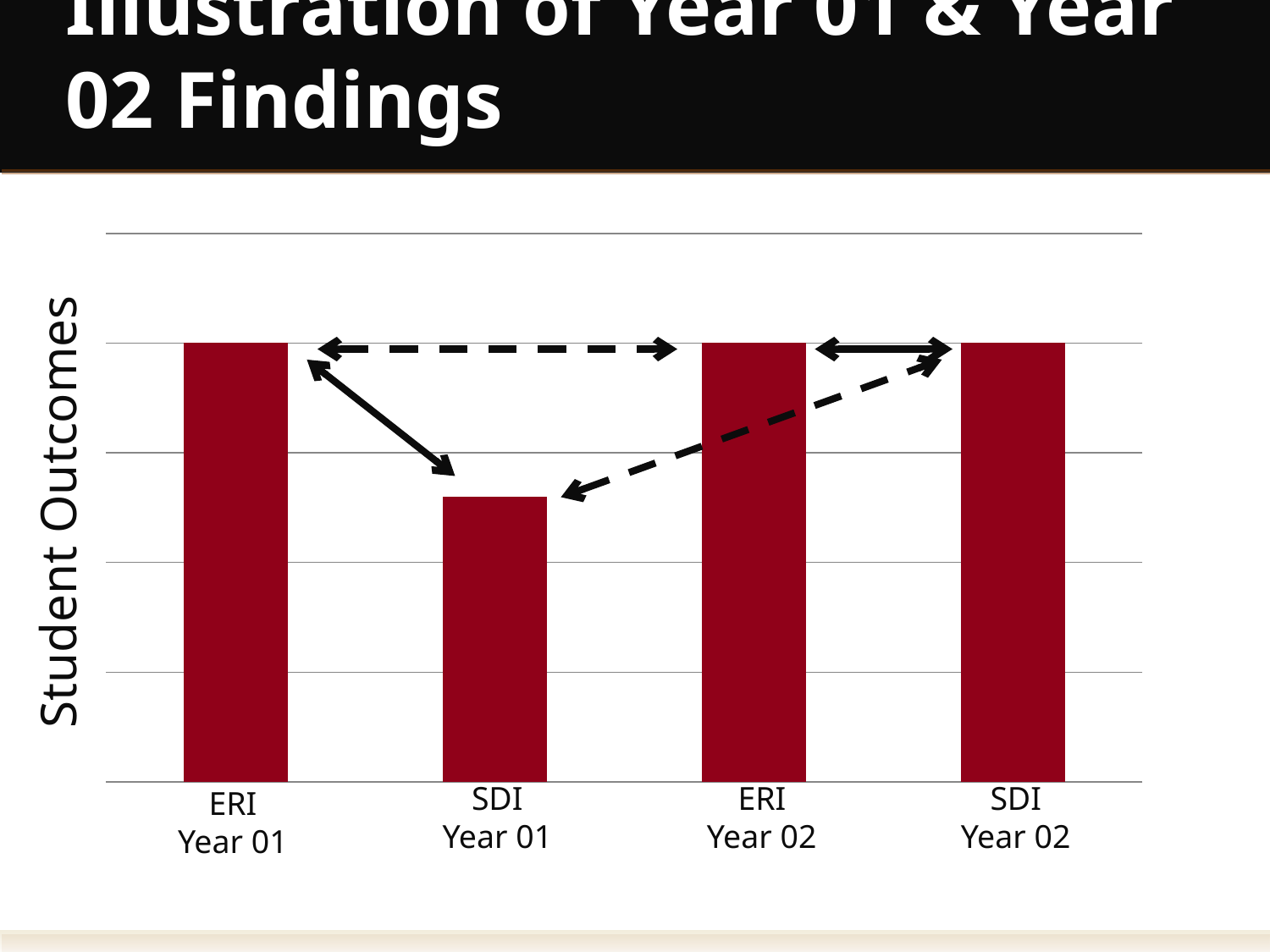
Does the SDI bar rise or fall from Year 01 to Year 02? rise Which is larger, the bar for ERI Year 01 or the bar for SDI Year 01? ERI Year 01 How many bars are plotted in the chart? 4 Which is larger, the bar for ERI Year 02 or the bar for SDI Year 01? ERI Year 02 What kind of chart is shown on the slide? bar chart Which is larger, the bar for SDI Year 01 or the bar for SDI Year 02? SDI Year 02 Which category has the lowest bar in the chart? SDI Year 01 What colour are the bars in the chart? dark red What is the label on the vertical axis of the chart? Student Outcomes